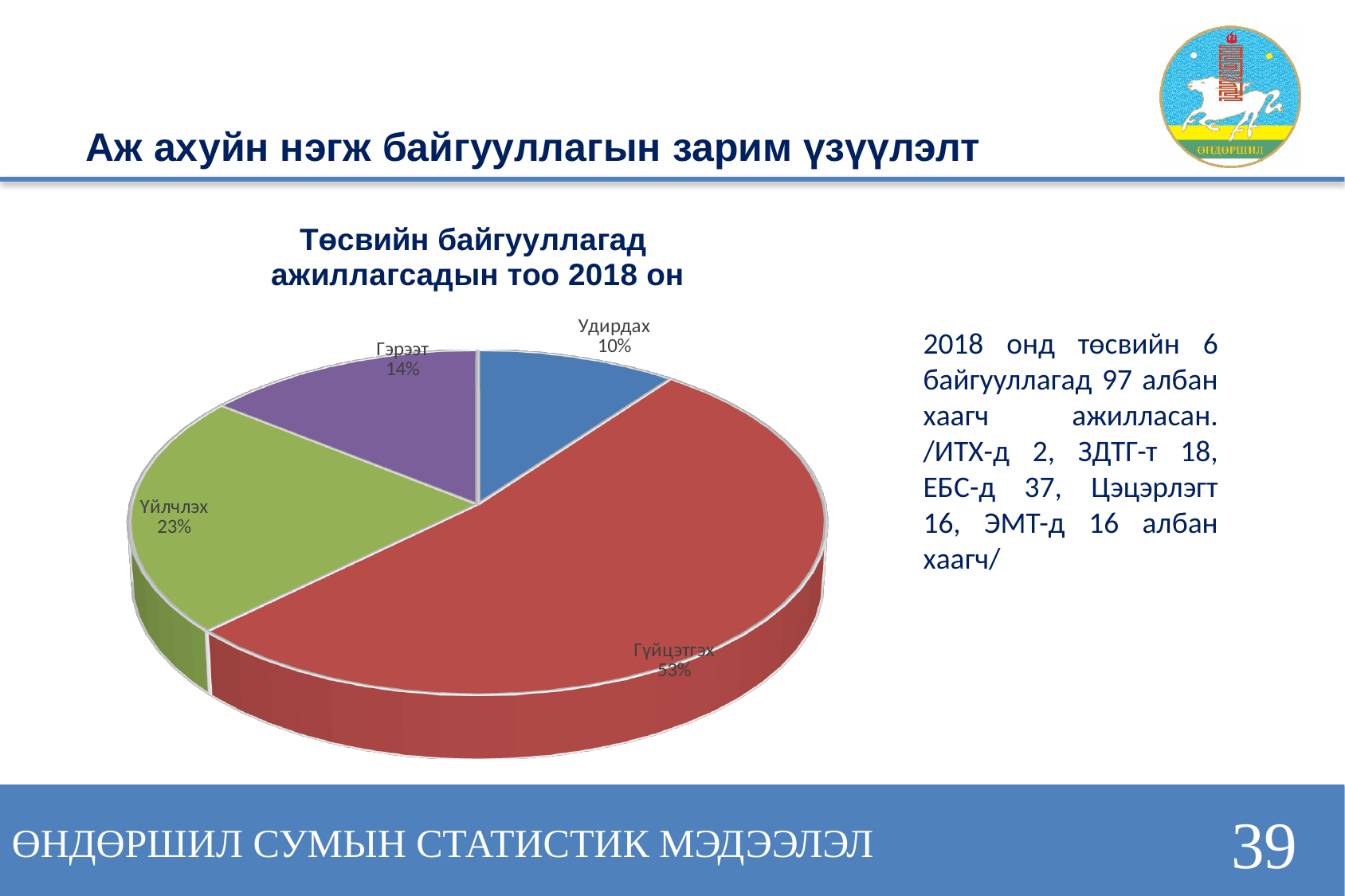
Which is larger, the share for Үйлчлэх or the share for Гэрээт? Үйлчлэх Which category has the smallest slice of the pie? Удирдах What share of the pie does Үйлчлэх have? 23% What share of the pie does Удирдах have? 10% What kind of chart is shown on the slide? pie chart What colour is the Гүйцэтгэх slice? red How many slices does the pie chart have? 4 Which category has the largest slice of the pie? Гүйцэтгэх What is the title of the chart? Төсвийн байгууллагад ажиллагсадын тоо 2018 он What is the difference in percentage points between Гүйцэтгэх and Үйлчлэх? 30 What share of the pie does Гүйцэтгэх have? 53%